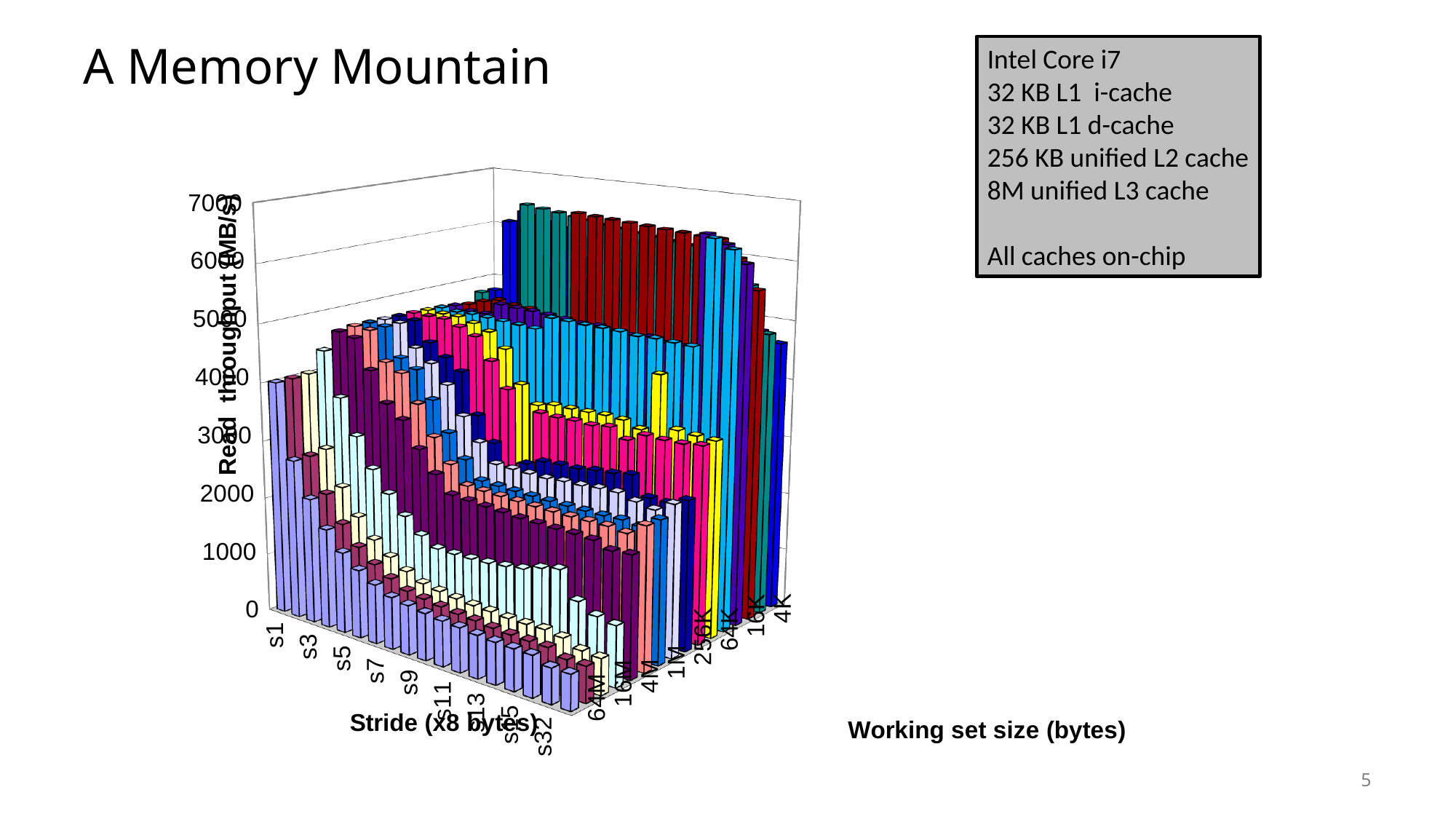
What kind of chart is shown on the slide? 3D bar chart What is the largest stride labeled on the chart's stride axis? s32 Which working set size has the lowest read throughput at stride s32? 64M Is the read throughput for stride s1 at a working set size of 64M greater or less than 5000? less How many working set size categories are labeled on the chart's depth axis? 8 What is the title of the chart on the slide? A Memory Mountain For a working set size of 64M, does read throughput rise or fall as the stride increases from s1 to s32? fall At stride s1, which has the larger read throughput: a working set size of 64M or 4K? 4K What is the smallest working set size labeled on the chart? 4K What is the maximum value shown on the vertical axis of the chart? 7000 What is the label of the vertical axis of the chart? Read throughput (MB/s)